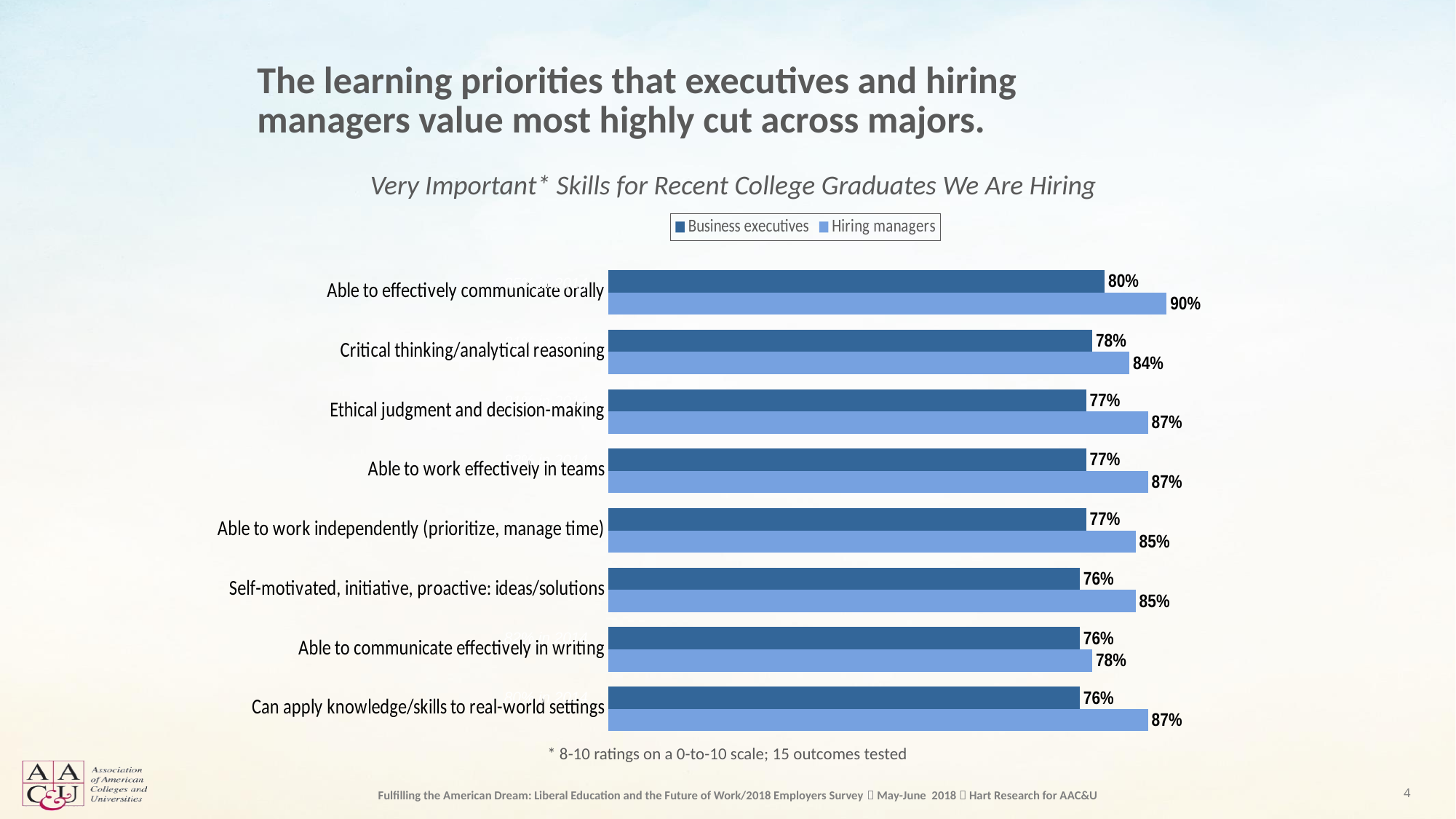
What is the difference between the hiring managers and business executives values for 'Can apply knowledge/skills to real-world settings'? 11 percentage points What kind of chart is shown on the slide? Bar chart What is the title of the chart? Very Important* Skills for Recent College Graduates We Are Hiring What percentage of hiring managers rate 'Critical thinking/analytical reasoning' as very important? 84% What percentage of business executives rate 'Able to effectively communicate orally' as very important? 80% What is the difference between the business executives values for 'Able to effectively communicate orally' and 'Critical thinking/analytical reasoning'? 2 percentage points How many skills are listed in the chart? 8 What is the hiring managers value for 'Able to communicate effectively in writing'? 78% Which skill has the lowest value among hiring managers? Able to communicate effectively in writing For 'Ethical judgment and decision-making', which group has the higher value: business executives or hiring managers? Hiring managers How many series does the legend list? 2 Which skill has the highest value among hiring managers? Able to effectively communicate orally